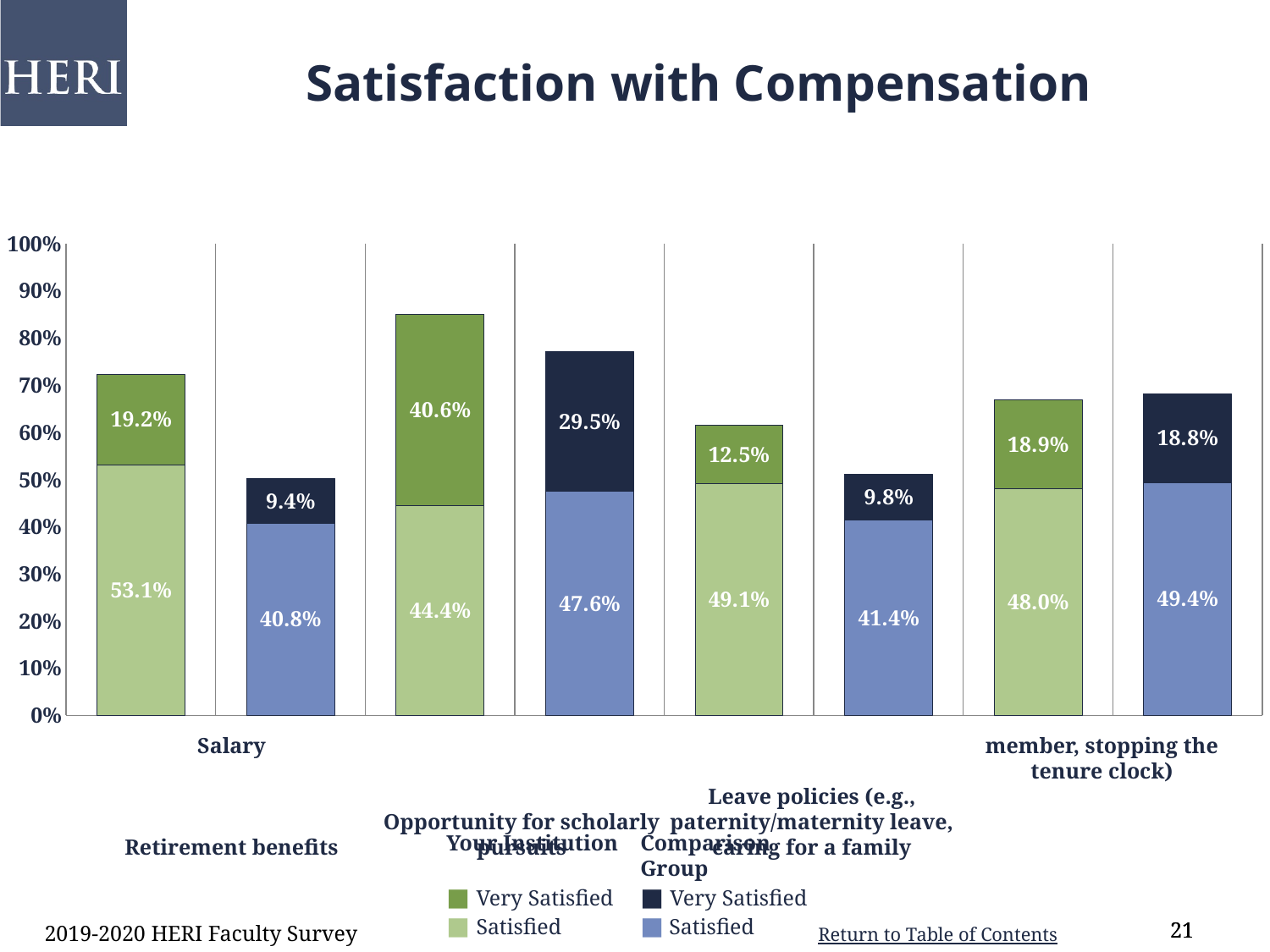
What is the total (Satisfied plus Very Satisfied) for the Comparison Group on Salary? 50.2% How many entries does the legend list? 4 Is the Very Satisfied percentage for Retirement benefits larger for Your Institution or the Comparison Group? Your Institution What percentage of faculty at Your Institution are Very Satisfied with Salary? 19.2% Which category has the highest Very Satisfied percentage for Your Institution? Retirement benefits What is the total (Satisfied plus Very Satisfied) for Your Institution on Retirement benefits? 85.0% What percentage of faculty at Your Institution are Satisfied with Opportunity for scholarly pursuits? 49.1% What is the difference between the Satisfied percentages for Your Institution and the Comparison Group on Salary? 12.3% What percentage of the Comparison Group are Satisfied with Retirement benefits? 47.6% What type of chart is shown on the slide? Stacked bar chart Which category has the lowest Very Satisfied percentage for the Comparison Group? Salary What percentage of the Comparison Group are Very Satisfied with Leave policies? 18.8%